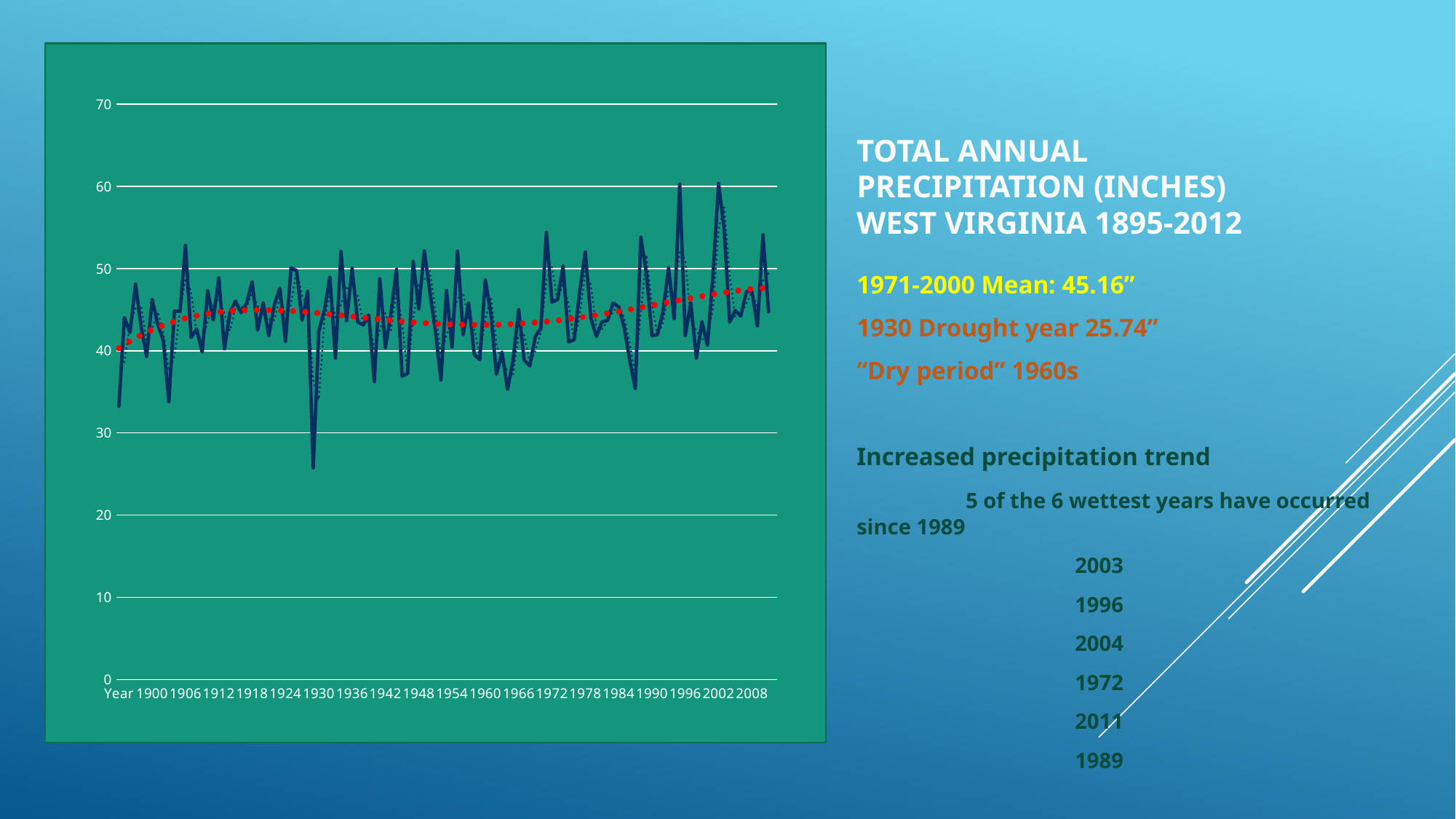
How many years apart are the consecutive year labels on the horizontal axis? 6 Does the red dotted trend line rise or fall from left to right across the years? rise What is the first year label shown on the horizontal axis after "Year"? 1900 What is the last year label shown on the horizontal axis? 2008 Is the value for 1930 greater or less than 30? less What is the highest value labelled on the vertical axis? 70 Is the value for 1930 greater or less than 40? less Is the lowest value plotted on the chart greater or less than 30? less What kind of chart is shown on the slide? line chart